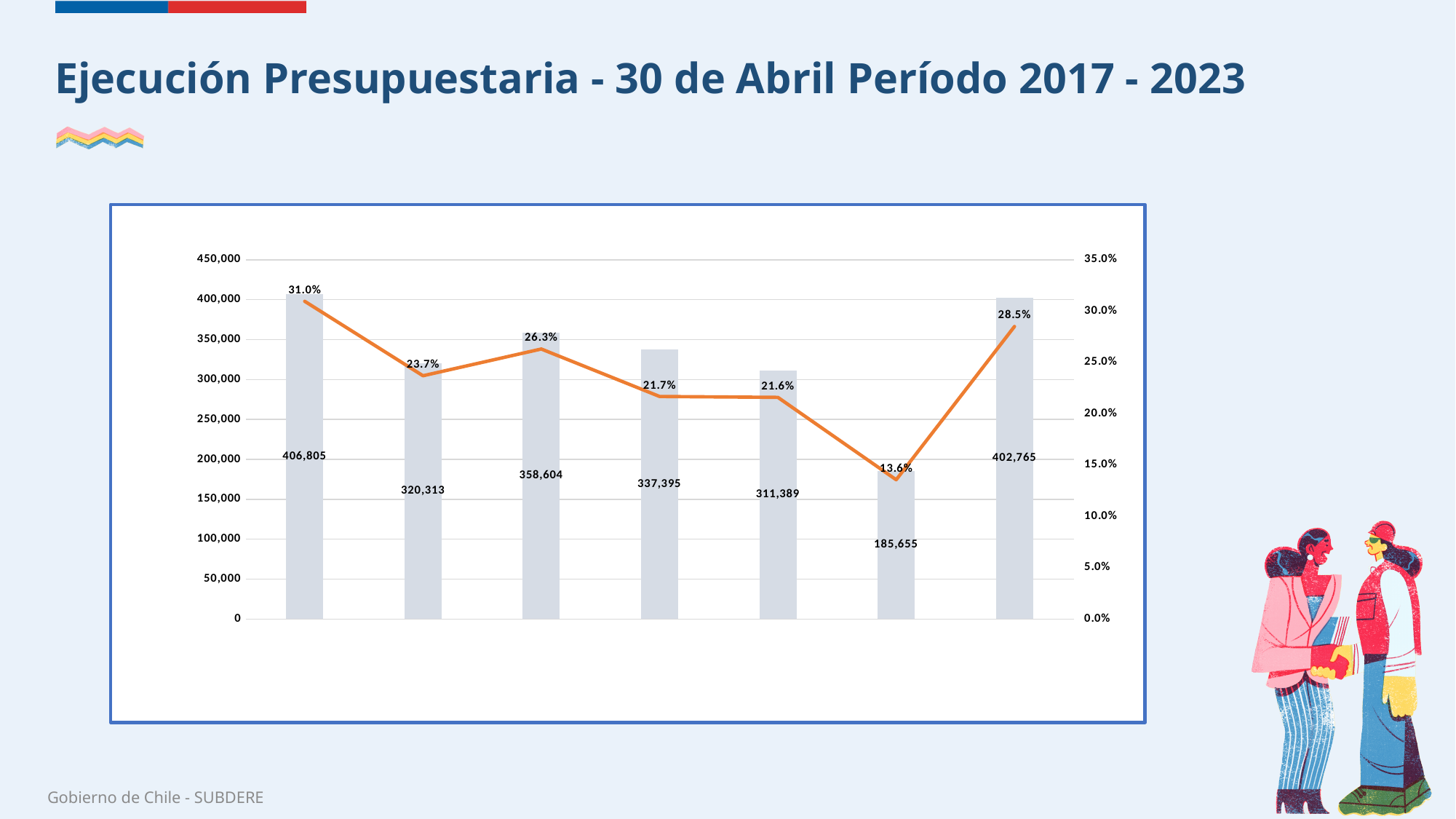
Which bar has the lowest value? The sixth bar (185,655) How many bars are plotted in the chart? 7 What is the data label on the first (leftmost) bar? 406,805 Which is larger, the third bar or the fourth bar? The third bar (358,604) Is the value of the second bar greater or less than 300,000? greater What kind of chart is shown? A combined bar and line chart Does the orange line rise or fall from the first point to the sixth point? It falls What percentage is shown on the orange line at the sixth point from the left? 13.6% What is the difference between the first bar (406,805) and the last bar (402,765)? 4,040 Which bar has the highest value? The first bar (406,805) What is the highest percentage shown on the orange line? 31.0% What is the data label on the last (rightmost) bar? 402,765